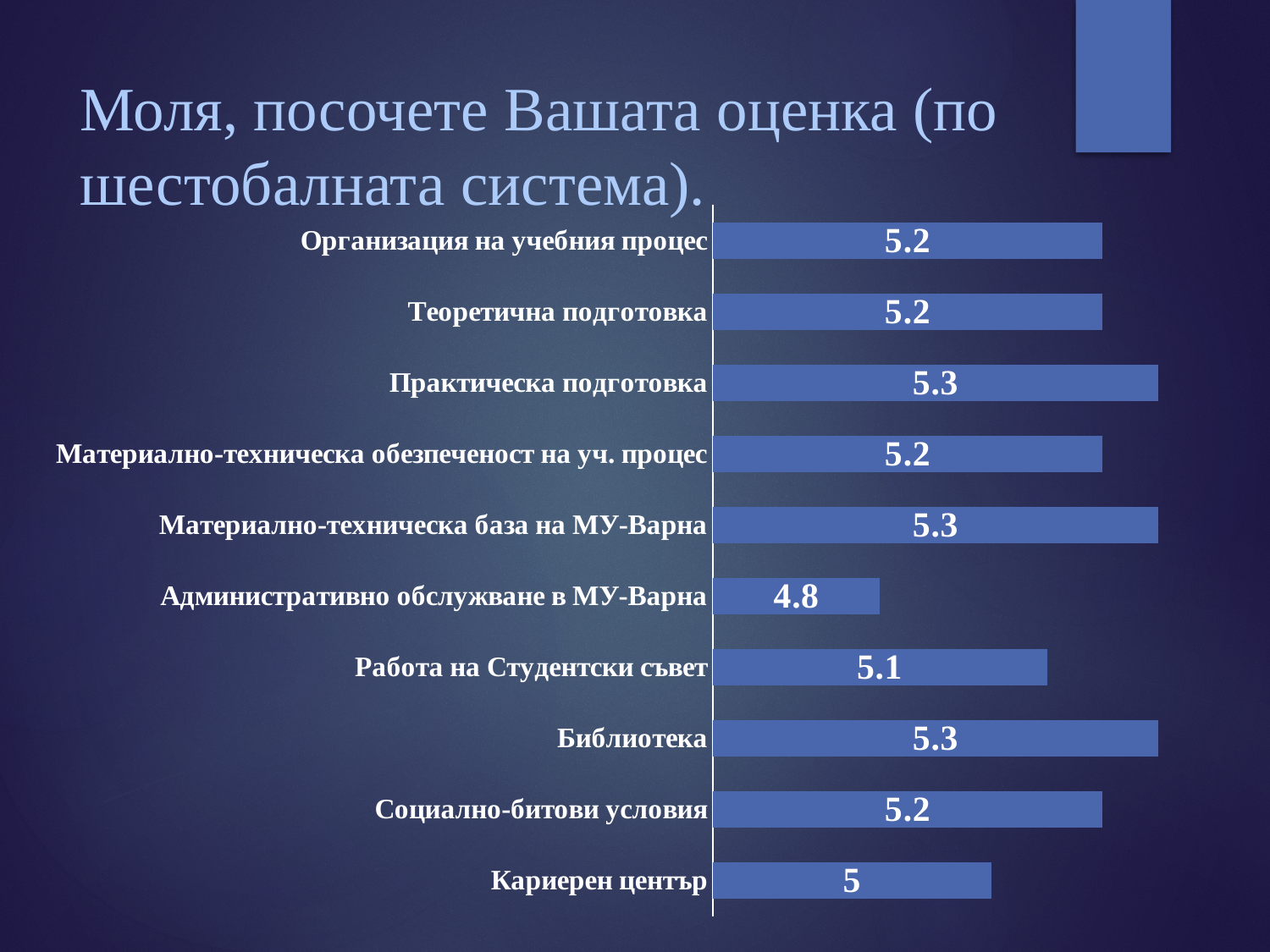
What kind of chart is shown on the slide? bar chart What is the difference between the values for Практическа подготовка and Административно обслужване в МУ-Варна? 0.5 What is the value for Кариерен център? 5 Which category has the lowest value? Административно обслужване в МУ-Варна Which is larger, the value for Библиотека or the value for Работа на Студентски съвет? Библиотека What is the value for Организация на учебния процес? 5.2 How many categories are shown in the chart? 10 What is the difference between the values for Социално-битови условия and Кариерен център? 0.2 Which is larger, the value for Кариерен център or the value for Теоретична подготовка? Теоретична подготовка What is the value for Библиотека? 5.3 What is the value for Работа на Студентски съвет? 5.1 What is the value for Административно обслужване в МУ-Варна? 4.8